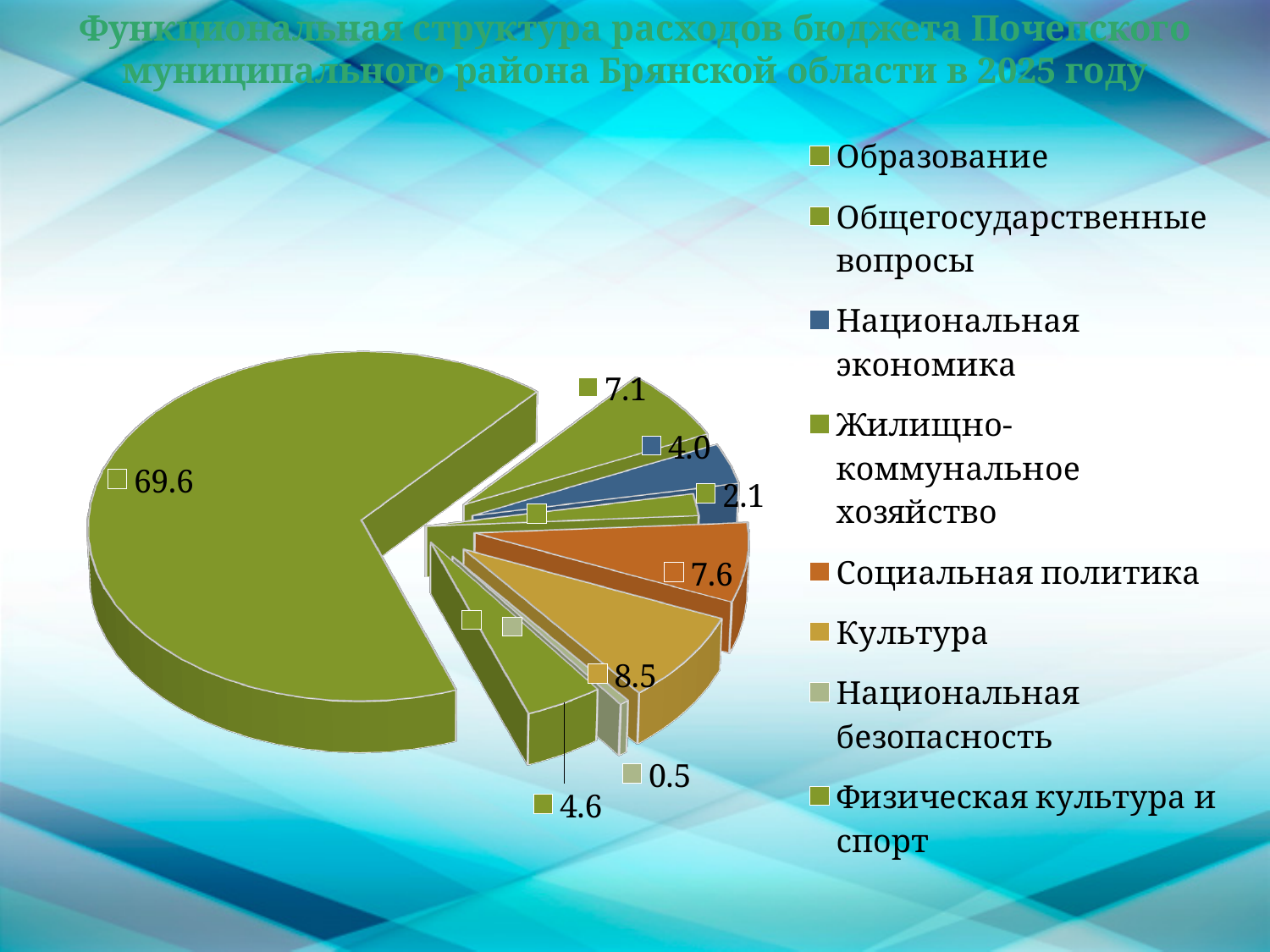
What is the value shown for Национальная безопасность? 0.5 Which category has the smallest slice of the pie? Национальная безопасность What is the difference between the values for Культура and Социальная политика? 0.9 What kind of chart is shown on the slide? pie chart What is the title of the chart on the slide? Функциональная структура расходов бюджета Почепского муниципального района Брянской области в 2025 году Which is larger, the value for Общегосударственные вопросы or the value for Физическая культура и спорт? Общегосударственные вопросы Which category has the largest slice of the pie? Образование What is the value shown for Национальная экономика? 4.0 What is the value shown for Социальная политика? 7.6 What is the value shown for Образование? 69.6 How many categories does the legend list? 8 What is the value shown for Культура? 8.5